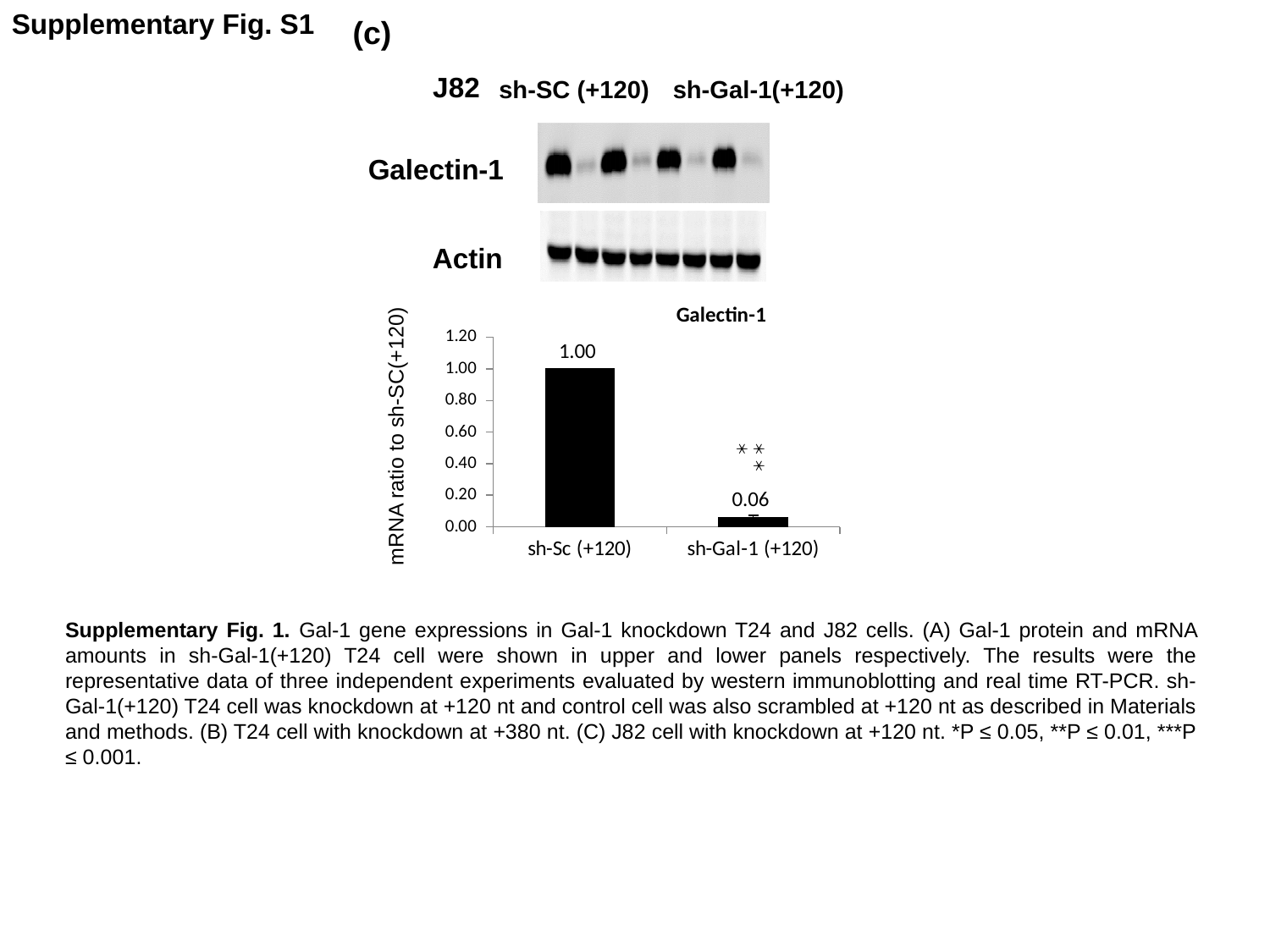
How many categories are shown on the x axis of the Galectin-1 chart? 2 Which category has the highest value in the Galectin-1 chart? sh-Sc (+120) What is the value for sh-Sc (+120) in the Galectin-1 chart? 1.00 What is the y-axis label of the bar chart? mRNA ratio to sh-SC(+120) Which is larger in the Galectin-1 chart, the value for sh-Sc (+120) or sh-Gal-1 (+120)? sh-Sc (+120) What is the value for sh-Gal-1 (+120) in the Galectin-1 chart? 0.06 Is the value for sh-Gal-1 (+120) greater or less than 0.20? less Do the values rise or fall from sh-Sc (+120) to sh-Gal-1 (+120) in the Galectin-1 chart? fall What is the difference between the values for sh-Sc (+120) and sh-Gal-1 (+120) in the Galectin-1 chart? 0.94 Which category has the lowest value in the Galectin-1 chart? sh-Gal-1 (+120) What kind of chart is the Galectin-1 chart? bar chart What is the title of the bar chart? Galectin-1